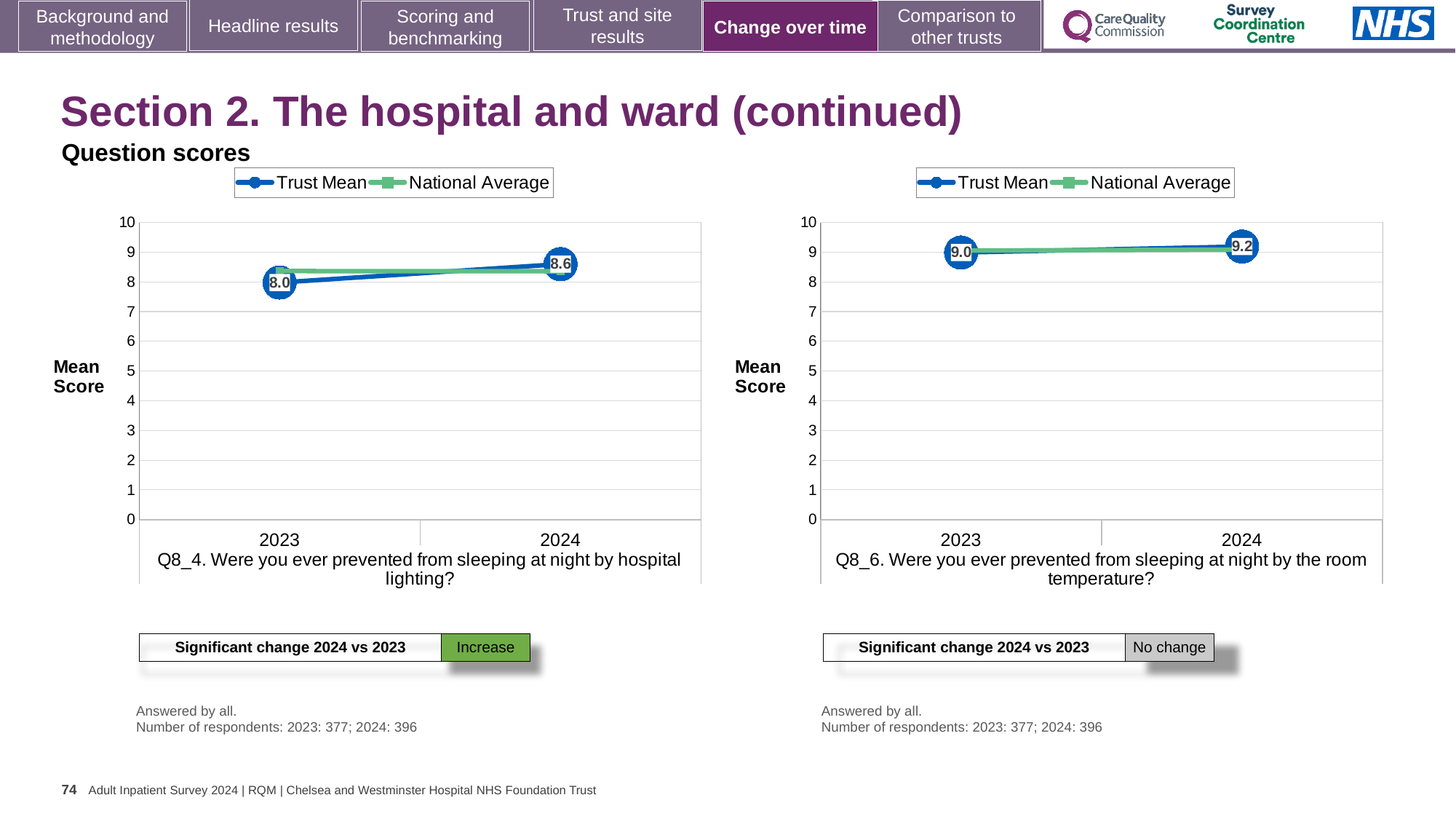
In the left chart (Q8_4, hospital lighting), what is the Trust Mean score for 2024? 8.6 What does the 'Significant change 2024 vs 2023' box below the left chart (Q8_4) say? Increase How many series does the legend of the left chart (Q8_4) list? 2 In the left chart (Q8_4, hospital lighting), what is the Trust Mean score for 2023? 8.0 In the right chart (Q8_6, room temperature), what is the Trust Mean score for 2024? 9.2 What kind of chart is used on this slide to show the question scores? line chart In the left chart (Q8_4, hospital lighting), by how much did the Trust Mean change from 2023 to 2024? 0.6 In the left chart (Q8_4, hospital lighting), does the Trust Mean rise or fall from 2023 to 2024? rise In the right chart (Q8_6, room temperature), what is the Trust Mean score for 2023? 9.0 In the left chart (Q8_4, hospital lighting), is the National Average for 2023 greater or less than 7? greater In the right chart (Q8_6, room temperature), what is the difference between the Trust Mean for 2024 and 2023? 0.2 How many years are plotted on the x axis of the right chart (Q8_6)? 2